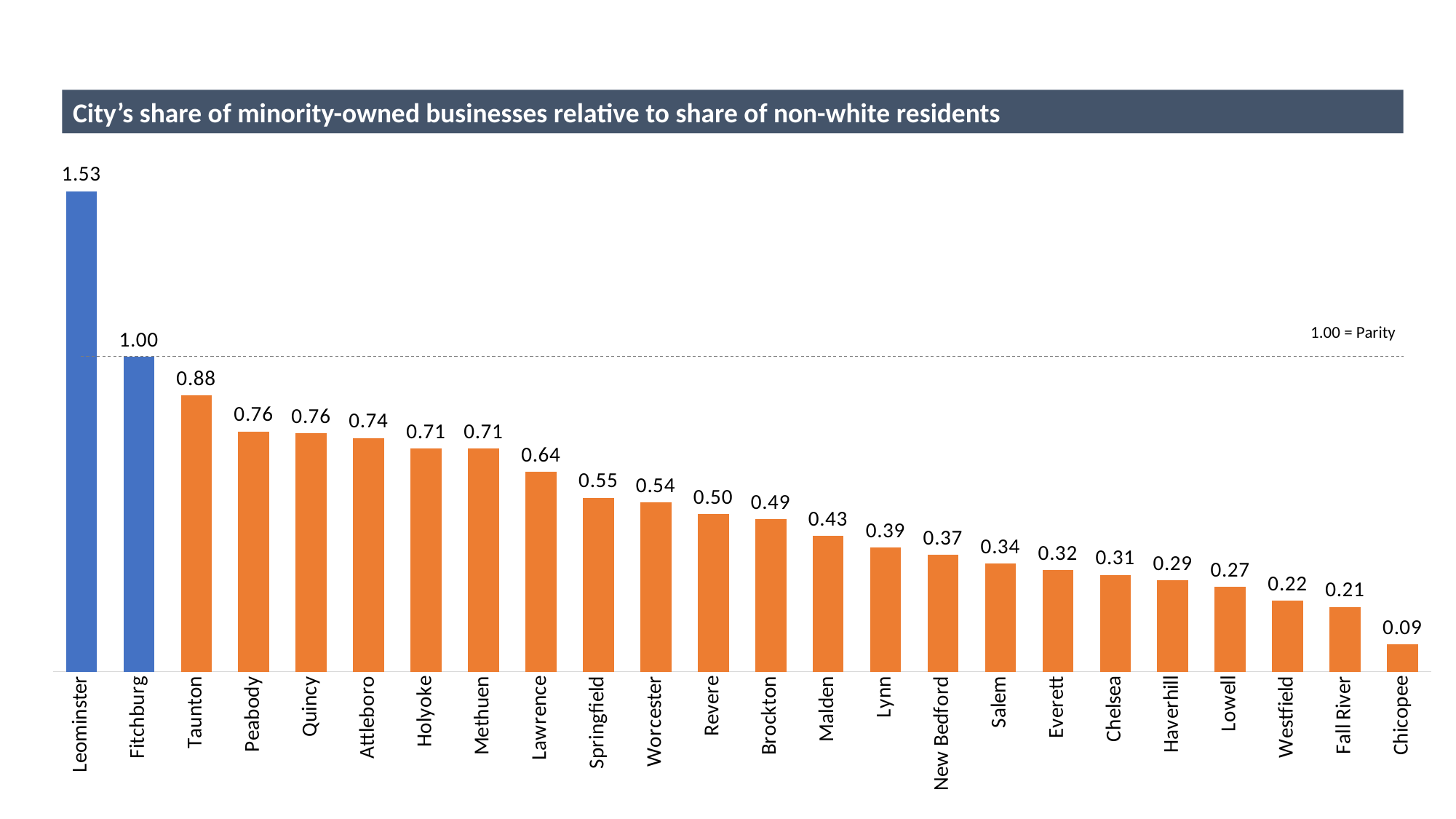
How many cities are shown on the chart? 24 What is the value for New Bedford? 0.37 What is the difference between the values for Leominster and Fitchburg? 0.53 What does the dashed horizontal line on the chart represent? 1.00 = Parity Do the values rise or fall from left to right along the x axis? Fall Which city has the highest value? Leominster What kind of chart is this? Bar chart What is the value for Leominster? 1.53 Which city has the lowest value? Chicopee Which has a larger value, Lawrence or Brockton? Lawrence What is the value for Worcester? 0.54 What is the difference between the values for Taunton and Chicopee? 0.79